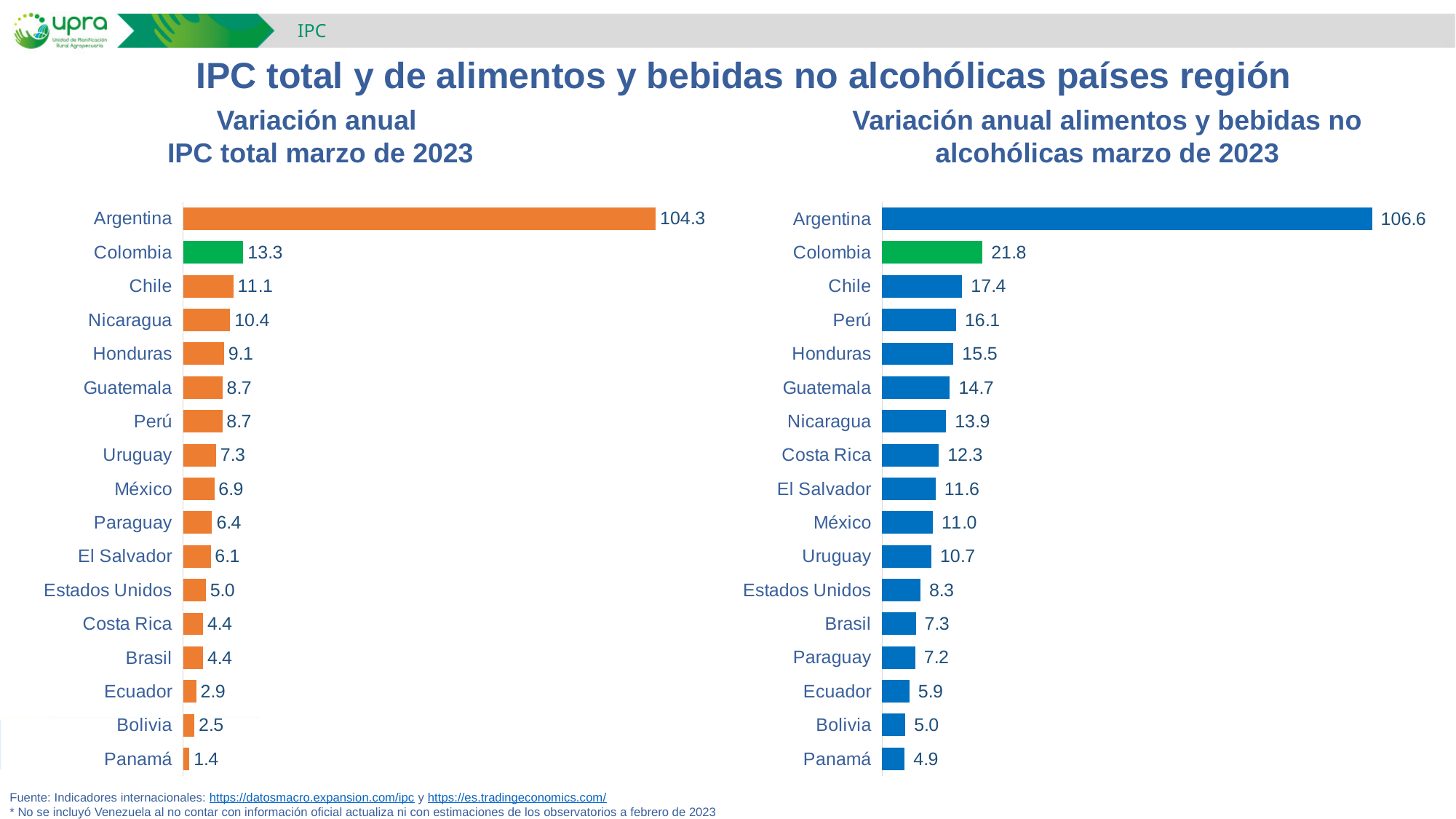
In the 'Variación anual IPC total marzo de 2023' chart, what is the difference between the values for Argentina and Colombia? 91.0 In the 'Variación anual alimentos y bebidas no alcohólicas marzo de 2023' chart, which country has the lowest value? Panamá In the 'Variación anual IPC total marzo de 2023' chart, which is larger, the value for Nicaragua or the value for Honduras? Nicaragua How many countries are shown in the 'Variación anual IPC total marzo de 2023' chart? 17 In the 'Variación anual alimentos y bebidas no alcohólicas marzo de 2023' chart, which is larger, the value for Perú or the value for Guatemala? Perú In the 'Variación anual IPC total marzo de 2023' chart, which country has the highest value? Argentina In the 'Variación anual IPC total marzo de 2023' chart, which country's bar is coloured green? Colombia In the 'Variación anual IPC total marzo de 2023' chart, what is the value for Panamá? 1.4 In the 'Variación anual IPC total marzo de 2023' chart, what is the value for Colombia? 13.3 In the 'Variación anual alimentos y bebidas no alcohólicas marzo de 2023' chart, what is the value for Chile? 17.4 What kind of chart is the 'Variación anual alimentos y bebidas no alcohólicas marzo de 2023' chart? Bar chart In the 'Variación anual alimentos y bebidas no alcohólicas marzo de 2023' chart, what is the difference between the values for Colombia and Chile? 4.4